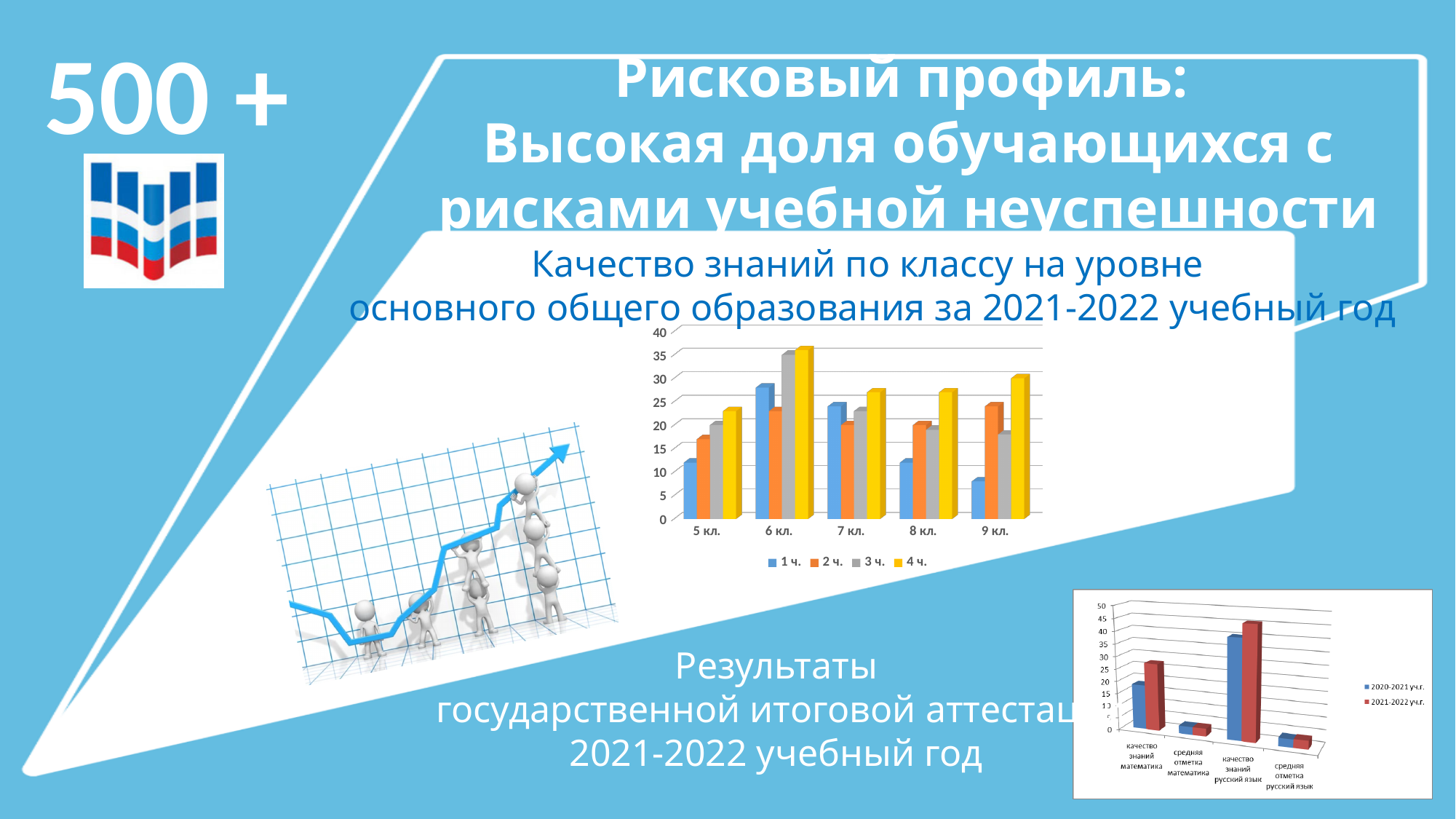
On the chart 'Результаты государственной итоговой аттестации 2021-2022 учебный год' (bottom right), is the 2021-2022 уч.г. value for качество знаний русский язык greater or less than 40? greater On the chart 'Качество знаний по классу', is the value for 1 ч. in 6 кл. greater or less than 25? greater On the chart 'Качество знаний по классу', which is larger for 1 ч.: 5 кл. or 6 кл.? 6 кл. On the chart 'Качество знаний по классу', is the value for 1 ч. in 9 кл. greater or less than 10? less On the chart 'Качество знаний по классу на уровне основного общего образования за 2021-2022 учебный год', how many series does the legend list? 4 On the chart 'Качество знаний по классу', which series has the lowest bar for 9 кл.? 1 ч. On the chart 'Качество знаний по классу на уровне основного общего образования за 2021-2022 учебный год', how many classes (categories) are shown on the x axis? 5 On the chart 'Результаты государственной итоговой аттестации 2021-2022 учебный год' (bottom right), which category has the highest bar? качество знаний русский язык On the chart 'Качество знаний по классу', which class has the highest bar overall? 6 кл. On the chart 'Качество знаний по классу', which series is shown in yellow in the legend? 4 ч. On the chart 'Результаты государственной итоговой аттестации 2021-2022 учебный год' (bottom right), how many series does the legend list? 2 What kind of chart is the 'Качество знаний по классу' chart? Bar chart